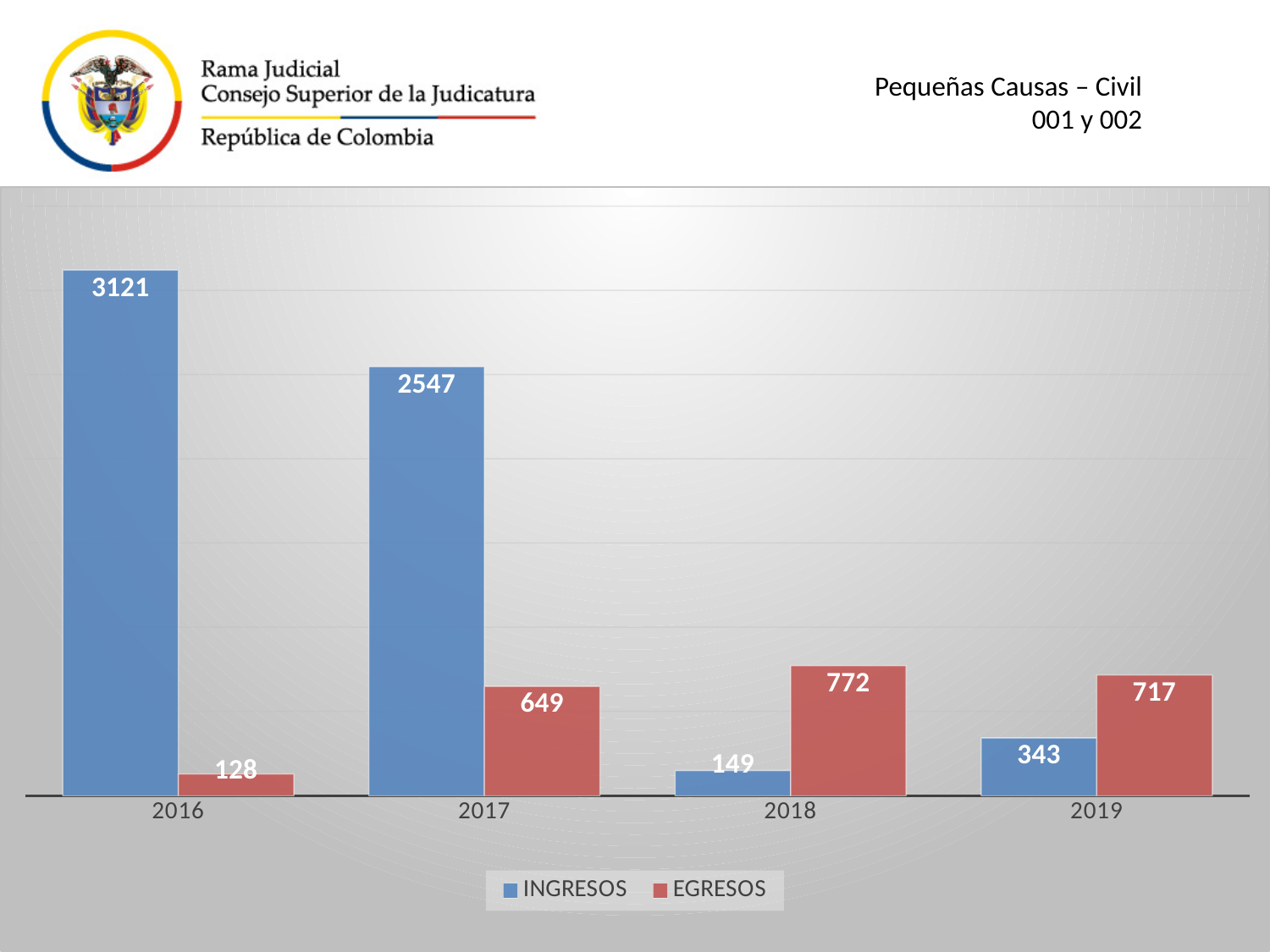
What is the INGRESOS value for 2019? 343 What is the EGRESOS value for 2016? 128 What is the difference between INGRESOS and EGRESOS in 2017? 1898 What is the INGRESOS value for 2016? 3121 How many years are shown on the x axis? 4 Which year has the highest INGRESOS value? 2016 Which is larger in 2018, INGRESOS or EGRESOS? EGRESOS How many series does the legend list? 2 Which year has the lowest EGRESOS value? 2016 What is the EGRESOS value for 2018? 772 Which colour represents EGRESOS in the chart? Red What kind of chart is shown on the slide? Bar chart